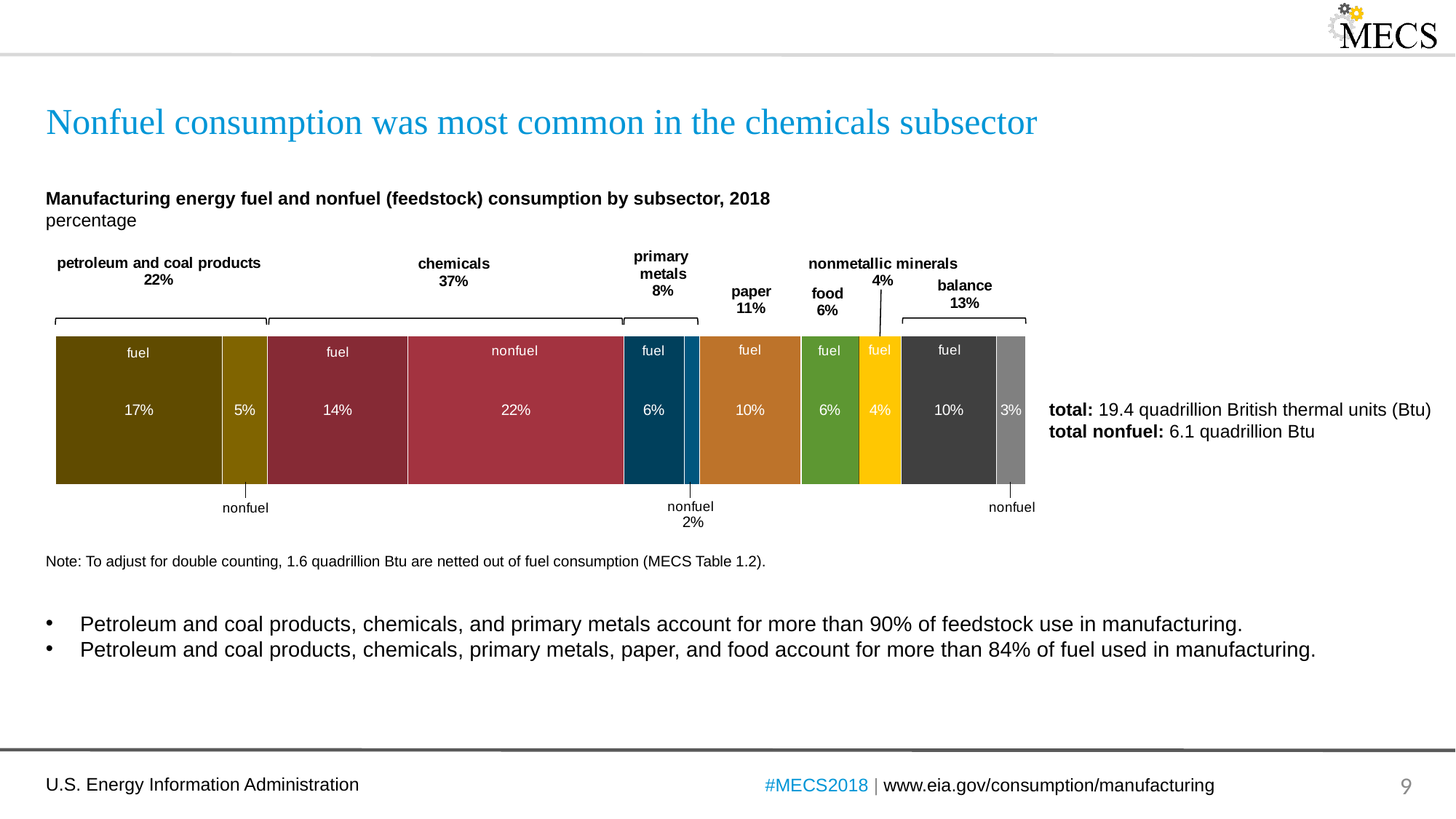
Which is larger, the fuel share for paper or the fuel share for food? paper What kind of chart is shown on the slide? bar chart How many subsector groups are labeled along the bar, including balance? 7 What is the total manufacturing energy consumption stated next to the chart? 19.4 quadrillion British thermal units (Btu) What is the difference between the chemicals subsector's total share and the petroleum and coal products subsector's total share? 15% Which named subsector has the smallest total share of manufacturing energy consumption? nonmetallic minerals What share of manufacturing energy consumption does the chemicals subsector account for? 37% Which subsector has the largest total share of manufacturing energy consumption? chemicals What is the nonfuel share for the chemicals subsector? 22% What is the nonfuel share for primary metals? 2% What is the fuel share for petroleum and coal products? 17% What is the total nonfuel consumption stated next to the chart? 6.1 quadrillion Btu